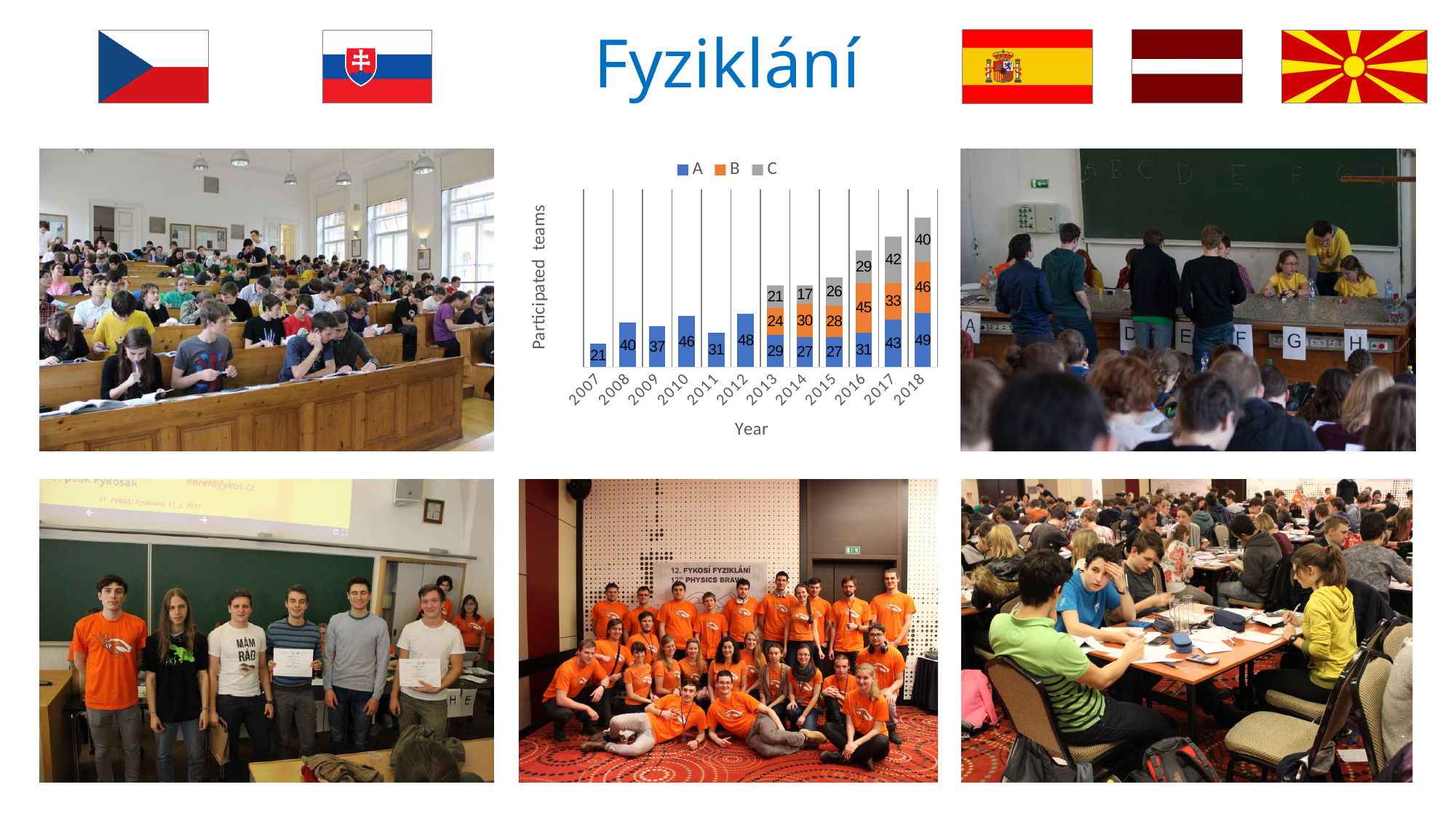
What is the value of series B in 2016? 45 Which year has the highest value for series A? 2018 What is the value of series C in 2018? 40 Which year has the lowest value for series A? 2007 What is the total number of participated teams in 2018 (all series combined)? 135 What kind of chart is shown on the slide? stacked bar chart What is the difference between the series A values for 2018 and 2007? 28 How many series does the chart legend list? 3 What is the label of the y axis of the chart? Participated teams What is the value of series A in 2007? 21 Which is larger: series B in 2017 or series C in 2017? series C in 2017 How many years are shown on the x axis of the chart? 12